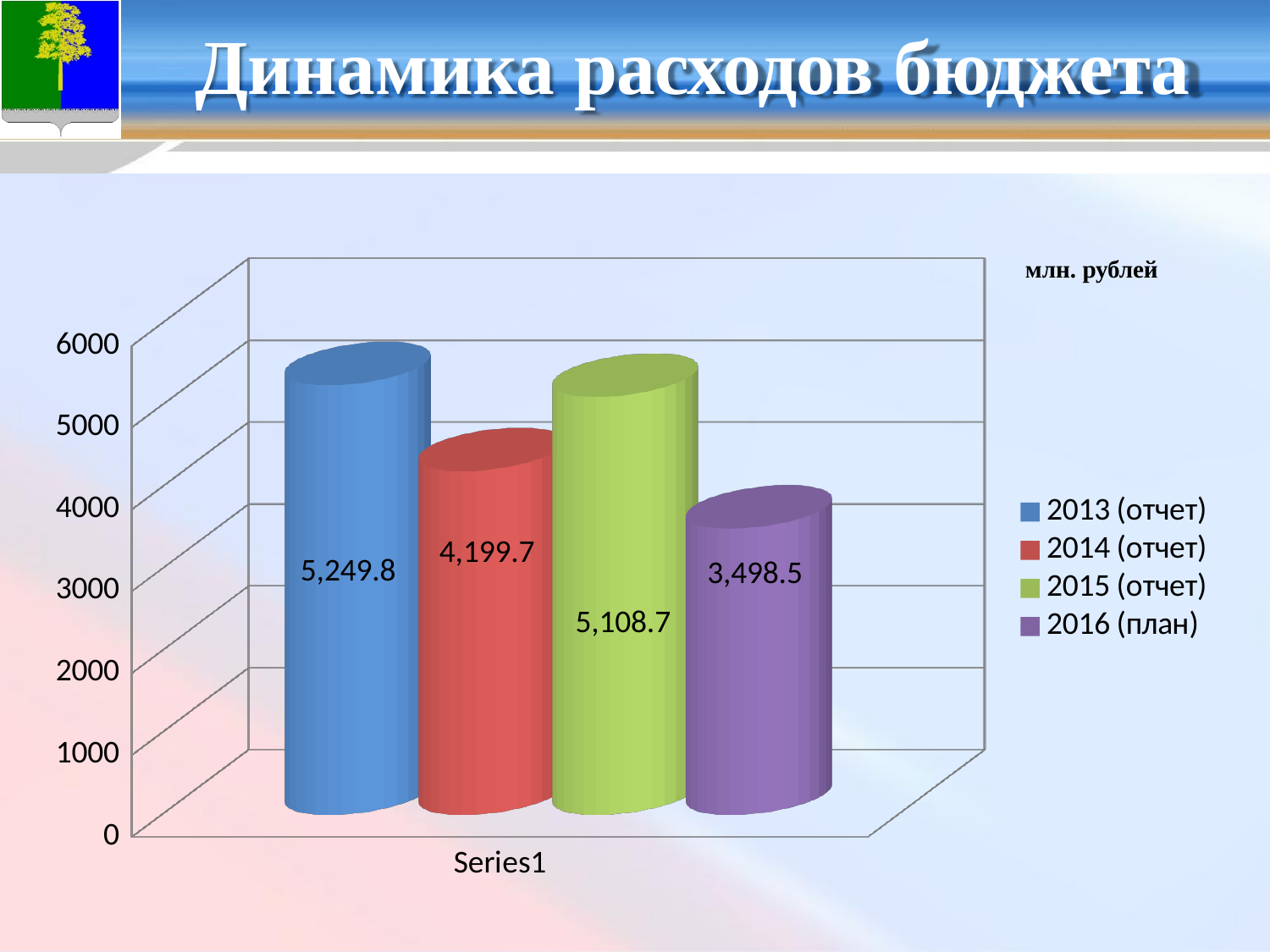
Which year has the lowest value? 2016 (план) Which year has the highest value? 2013 (отчет) Which is larger, the value for 2014 (отчет) or the value for 2015 (отчет)? 2015 (отчет) How many entries does the legend list? 4 What is the value for 2016 (план)? 3,498.5 What is the value for 2014 (отчет)? 4,199.7 What kind of chart is shown on the slide? bar chart What is the difference between the values for 2013 (отчет) and 2016 (план)? 1,751.3 What unit is indicated for the values in the chart? млн. рублей What is the value for 2013 (отчет)? 5,249.8 Is the value for 2016 (план) greater or less than 4000? less What is the value for 2015 (отчет)? 5,108.7